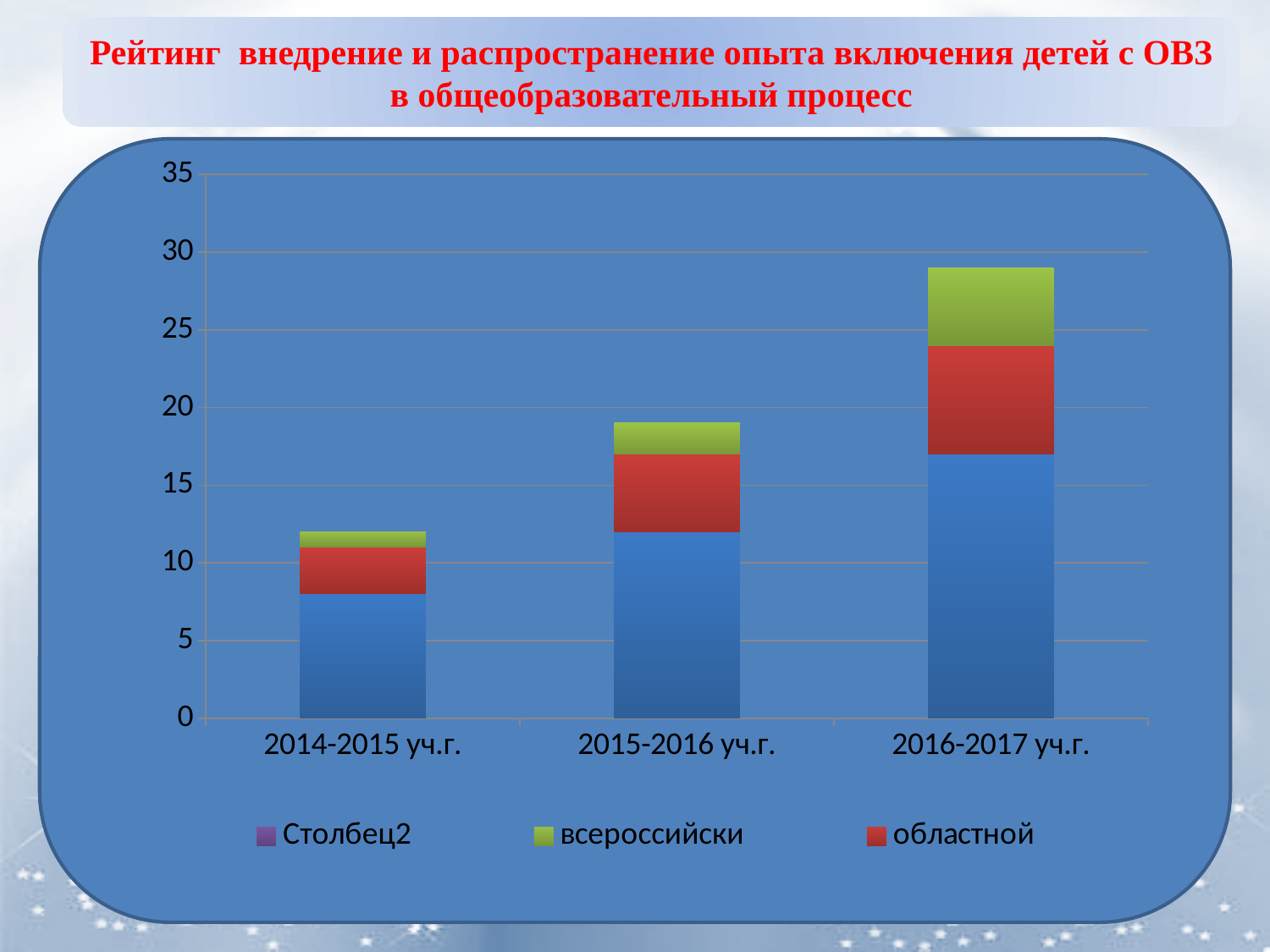
Which stacked bar is taller, 2015-2016 уч.г. or 2016-2017 уч.г.? 2016-2017 уч.г. Which academic year has the tallest stacked bar? 2016-2017 уч.г. Is the total height of the bar for 2016-2017 уч.г. greater or less than 25? greater Is the total height of the bar for 2014-2015 уч.г. greater or less than 15? less Do the stacked bar totals rise or fall from 2014-2015 уч.г. to 2016-2017 уч.г.? rise Is the total height of the bar for 2015-2016 уч.г. greater or less than 15? greater Which legend entry is shown in red? областной Which legend entry is shown in green? всероссийски How many series does the legend list? 3 Which academic year has the shortest stacked bar? 2014-2015 уч.г. How many categories (academic years) are shown on the x axis? 3 What kind of chart is shown on the slide? bar chart